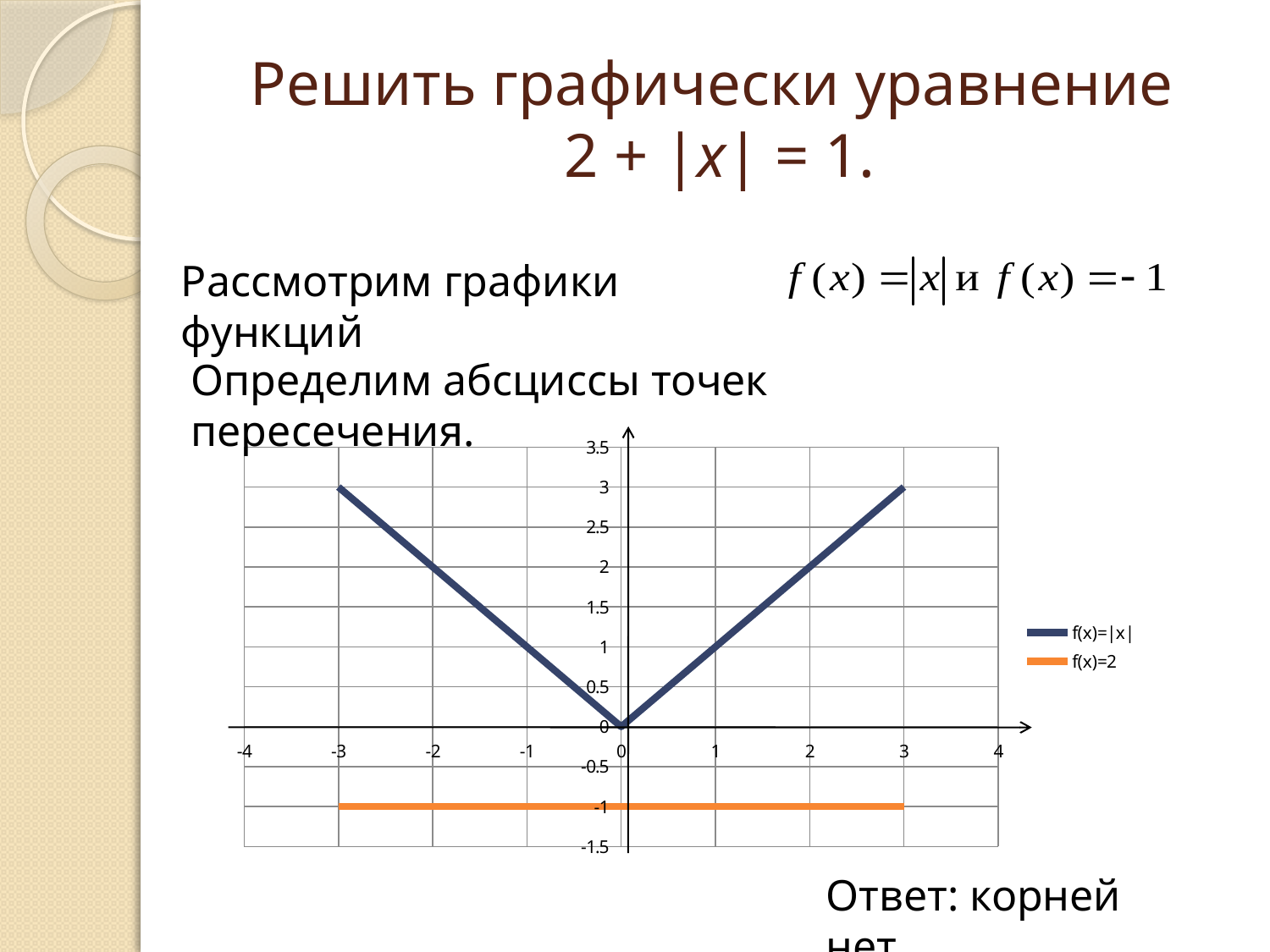
What are the two series named in the chart legend? f(x)=|x| and f(x)=2 What colour is the line for the series f(x)=2 in the chart? orange At x = 3, what is the difference between the value of f(x)=|x| and the value of the orange line? 4 At x = 2, which series has the larger value, f(x)=|x| or the orange line? f(x)=|x| What kind of chart is shown on the slide? line chart At what y value is the horizontal orange line plotted on the chart? -1 What is the value of f(x)=|x| at x = 0 on the chart? 0 At which x value does the line f(x)=|x| reach its lowest point on the chart? 0 Does the line f(x)=|x| rise or fall as x goes from 0 to 3? rise What is the value of f(x)=|x| at x = 3 on the chart? 3 How many series does the chart legend list? 2 Is the value of f(x)=|x| at x = 2 greater or less than 1? greater